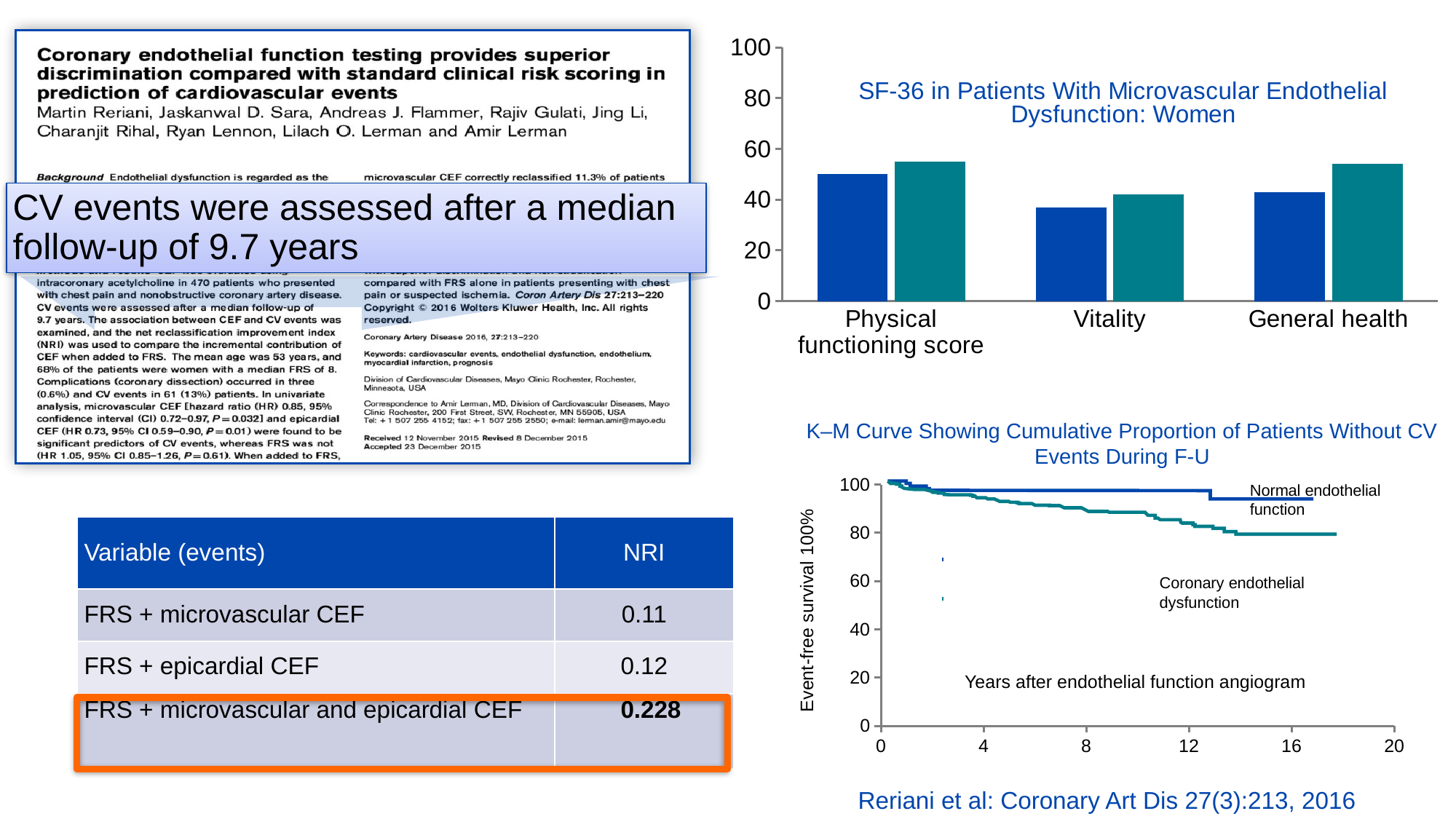
In the SF-36 bar chart, is the dark blue bar for Vitality greater or less than 40? less In the SF-36 bar chart, for Vitality, which bar is taller, the dark blue bar or the teal bar? The teal bar What kind of chart is the 'K–M Curve Showing Cumulative Proportion of Patients Without CV Events During F-U' chart? Line chart In the SF-36 bar chart, is the teal bar for General health greater or less than 40? greater What kind of chart is the 'SF-36 in Patients With Microvascular Endothelial Dysfunction: Women' chart? Bar chart In the K–M curve chart, is the Coronary endothelial dysfunction curve at 16 years greater or less than 90? less In the K–M curve chart, which curve is higher at 16 years, Normal endothelial function or Coronary endothelial dysfunction? Normal endothelial function In the SF-36 bar chart, which category has the lowest bar overall? Vitality In the SF-36 bar chart, for General health, which bar is taller, the dark blue bar or the teal bar? The teal bar In the K–M curve chart, what is the label of the y axis? Event-free survival 100% How many categories are shown on the x axis of the SF-36 bar chart? 3